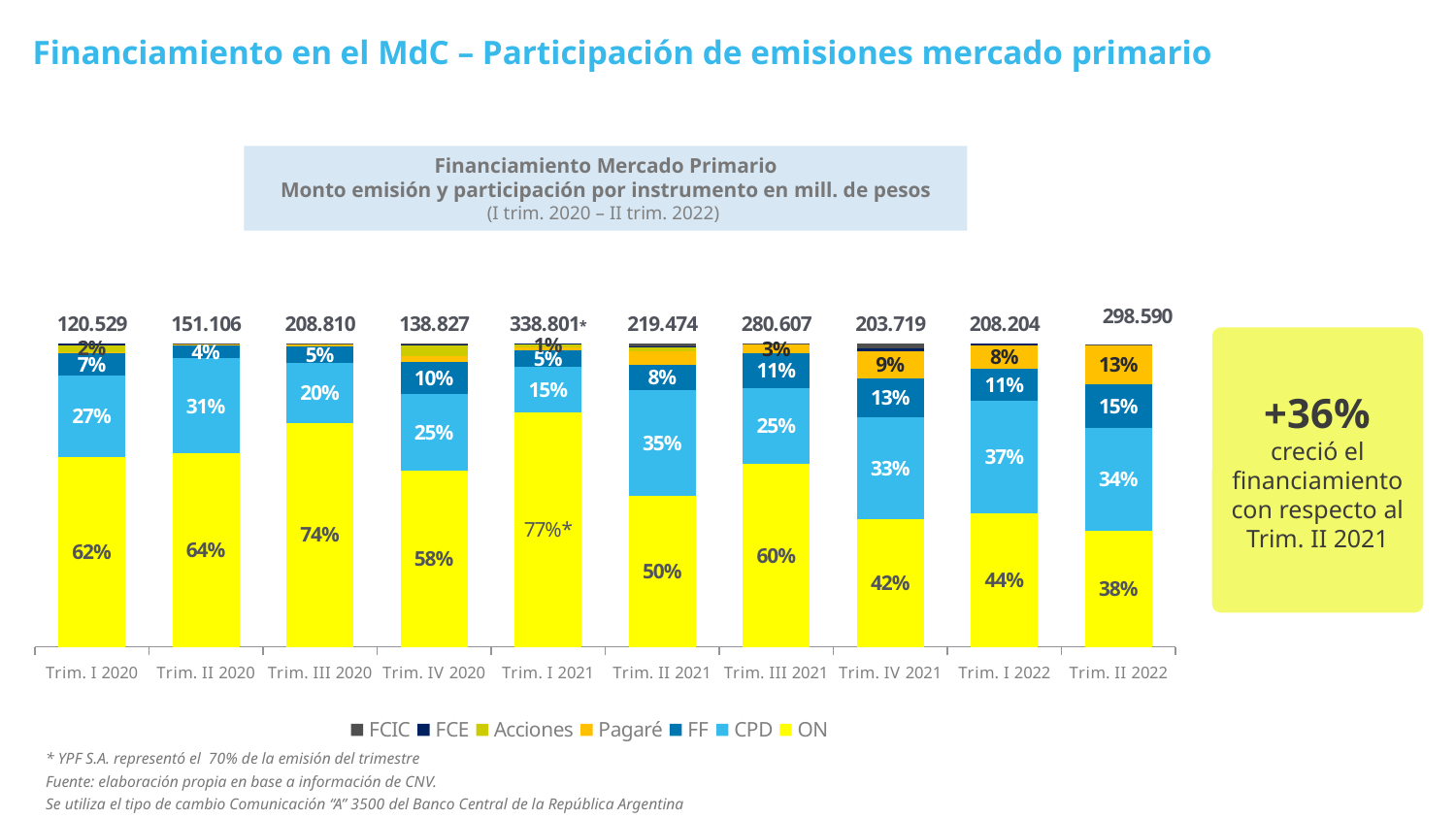
What is the FF share in Trim. II 2022? 15% Which is larger, the ON share in Trim. III 2020 or in Trim. IV 2020? Trim. III 2020 What kind of chart is shown on the slide? Stacked bar chart What share of the emission in Trim. III 2020 corresponds to ON? 74% By how many percentage points is the ON share in Trim. I 2020 higher than in Trim. II 2022? 24 percentage points What is the CPD share in Trim. I 2022? 37% What is the Pagaré share in Trim. II 2022? 13% Which quarter has the highest total emission amount? Trim. I 2021 How many series does the chart legend list? 7 Which quarter has the lowest total emission amount? Trim. I 2020 What is the total emission amount shown above the bar for Trim. II 2022? 298.590 How many quarters (categories) are shown on the x axis of the chart? 10